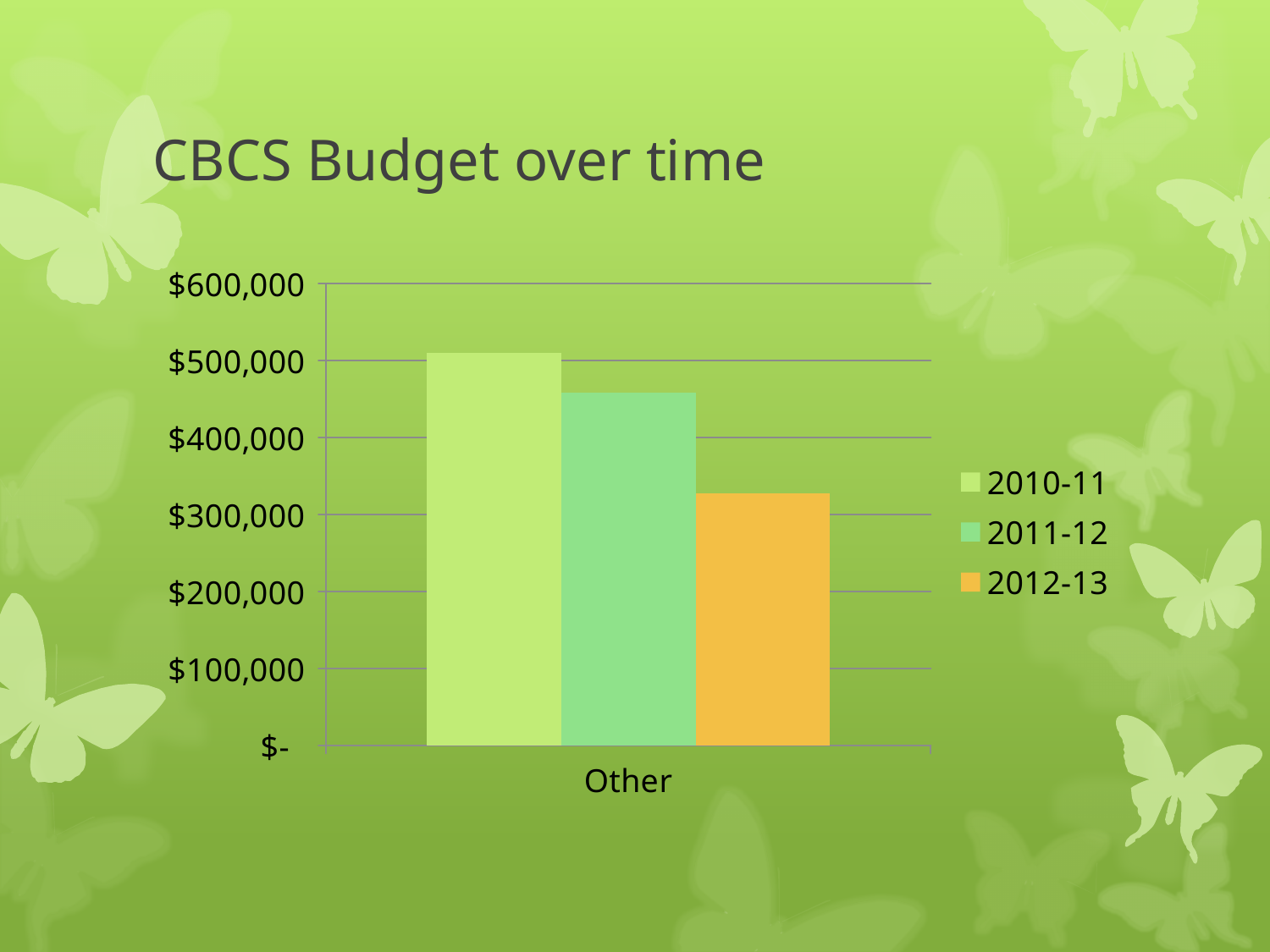
What kind of chart is shown on the slide? bar chart How many series does the legend list? 3 Is the value for 2010-11 greater or less than $400,000? greater Which series has the highest value? 2010-11 What is the title of the slide? CBCS Budget over time Is the value for 2011-12 greater or less than $500,000? less Which series has the lowest value? 2012-13 How many categories are shown on the x axis? 1 What colour is the bar for 2012-13? orange Which is larger, the value for 2010-11 or the value for 2012-13? 2010-11 Is the value for 2012-13 greater or less than $400,000? less Do the budget values rise or fall from 2010-11 to 2012-13? fall